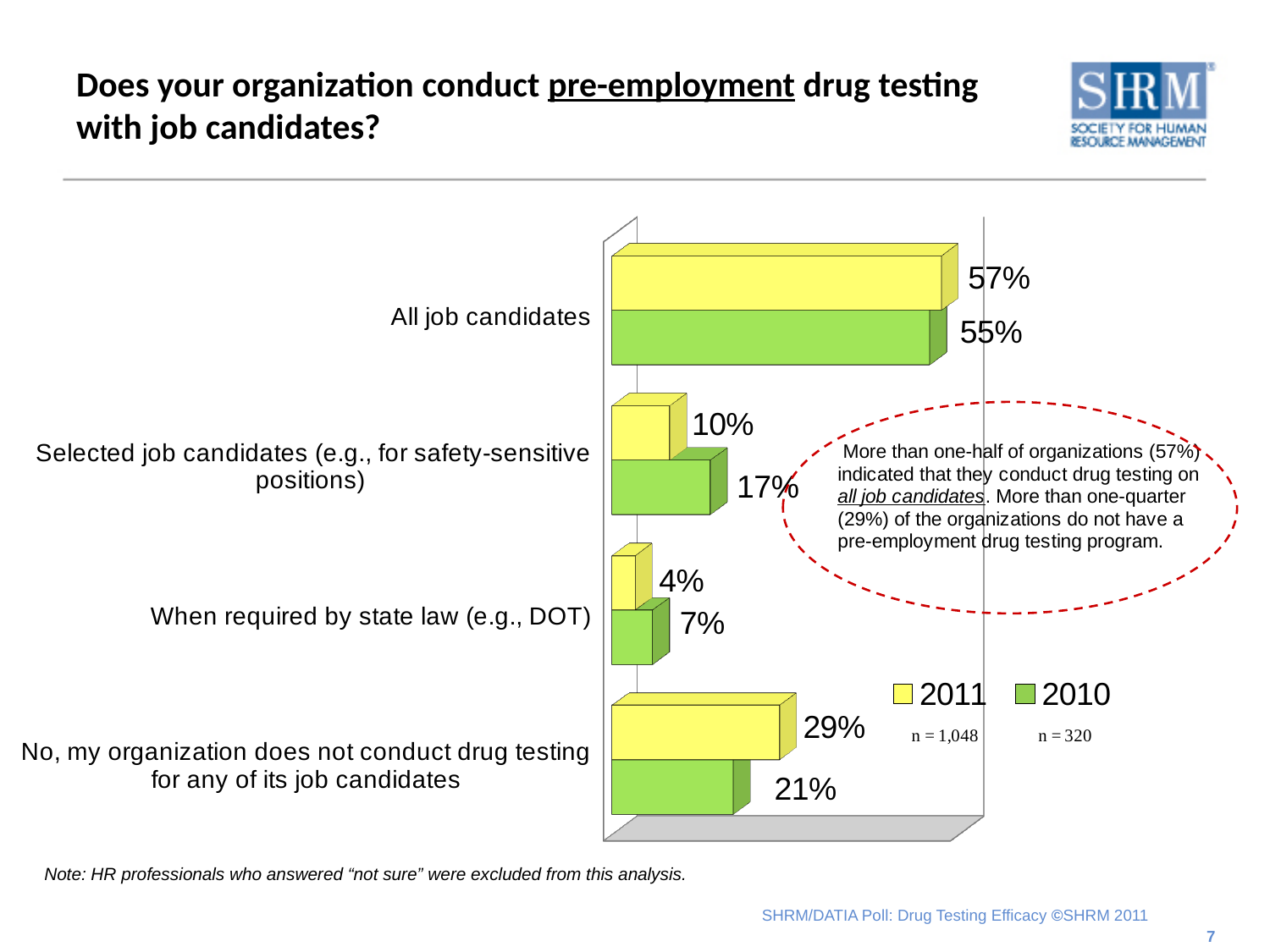
What percentage of organizations in 2011 conduct pre-employment drug testing on all job candidates? 57% Which category has the highest value for the 2011 series? All job candidates What is the 2011 value for 'When required by state law (e.g., DOT)'? 4% How many categories are shown in the chart? 4 What is the 2010 value for 'Selected job candidates (e.g., for safety-sensitive positions)'? 17% What percentage of organizations in 2010 did not conduct drug testing for any of their job candidates? 21% What kind of chart is shown on the slide? Bar chart What is the sample size (n) for the 2011 series shown in the legend? n = 1,048 Which category has the lowest value for the 2010 series? When required by state law (e.g., DOT) What is the difference between the 2011 and 2010 values for 'No, my organization does not conduct drug testing for any of its job candidates'? 8% For 'Selected job candidates (e.g., for safety-sensitive positions)', which year has the larger value, 2011 or 2010? 2010 How many series does the legend list? 2